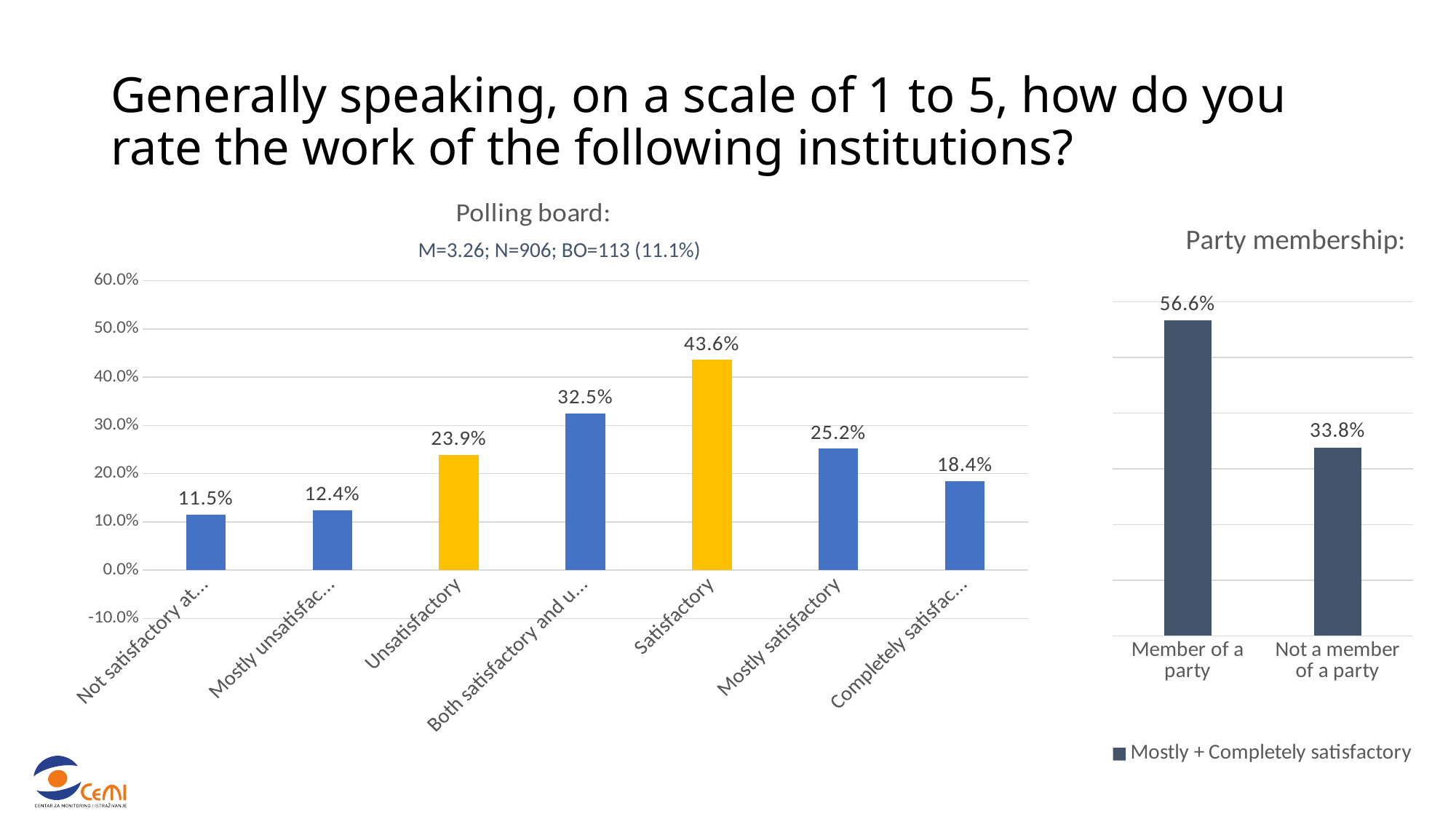
In the Party membership chart, what is the difference between Member of a party and Not a member of a party? 22.8% In the Polling board chart, what is the value for Unsatisfactory? 23.9% In the Party membership chart, what is the value for Member of a party? 56.6% In the Party membership chart, what series does the legend list? Mostly + Completely satisfactory In the Polling board chart, what is the difference between Satisfactory and Unsatisfactory? 19.7% In the Polling board chart, which is larger: Mostly satisfactory or Unsatisfactory? Mostly satisfactory In the Polling board chart, how many categories are shown? 7 In the Polling board chart, which category has the highest value? Satisfactory In the Party membership chart, what is the value for Not a member of a party? 33.8% What kind of chart is the Polling board chart? Bar chart In the Polling board chart, what is the value for Mostly satisfactory? 25.2% In the Polling board chart, what is the value for Satisfactory? 43.6%